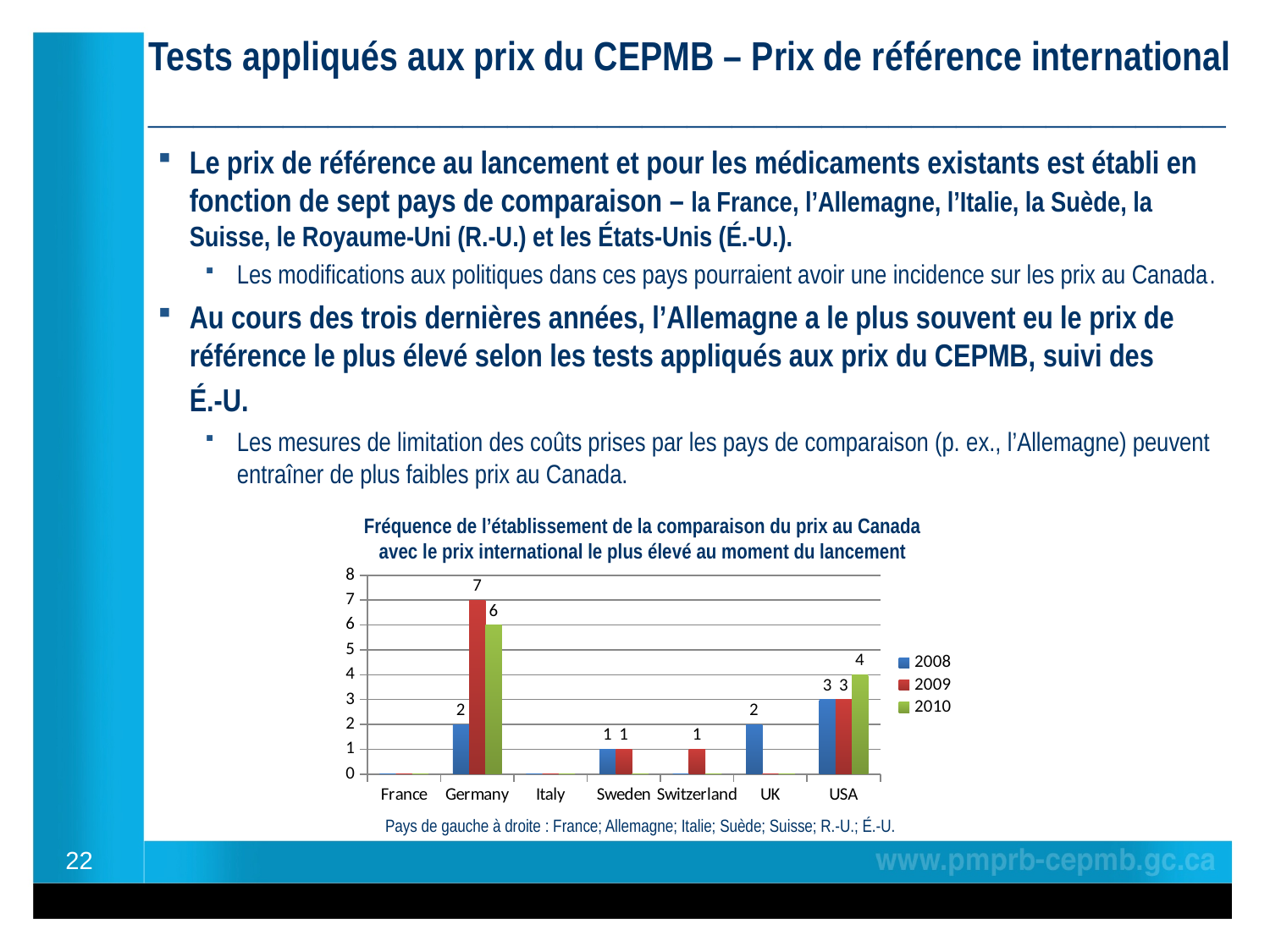
What is the value for Germany in 2009? 7 What is the value for the UK in 2008? 2 What is the value for Germany in 2010? 6 What kind of chart is shown on the slide? Bar chart Which country has the highest value in 2009? Germany What is the difference between Germany's 2009 value and its 2008 value? 5 Which is larger, the 2010 value for Germany or the 2010 value for the USA? Germany What is the value for the USA in 2010? 4 How many countries are shown on the x axis? 7 Which years are listed in the chart legend? 2008, 2009, 2010 How many series does the legend list? 3 Which country has the highest value in 2010? Germany